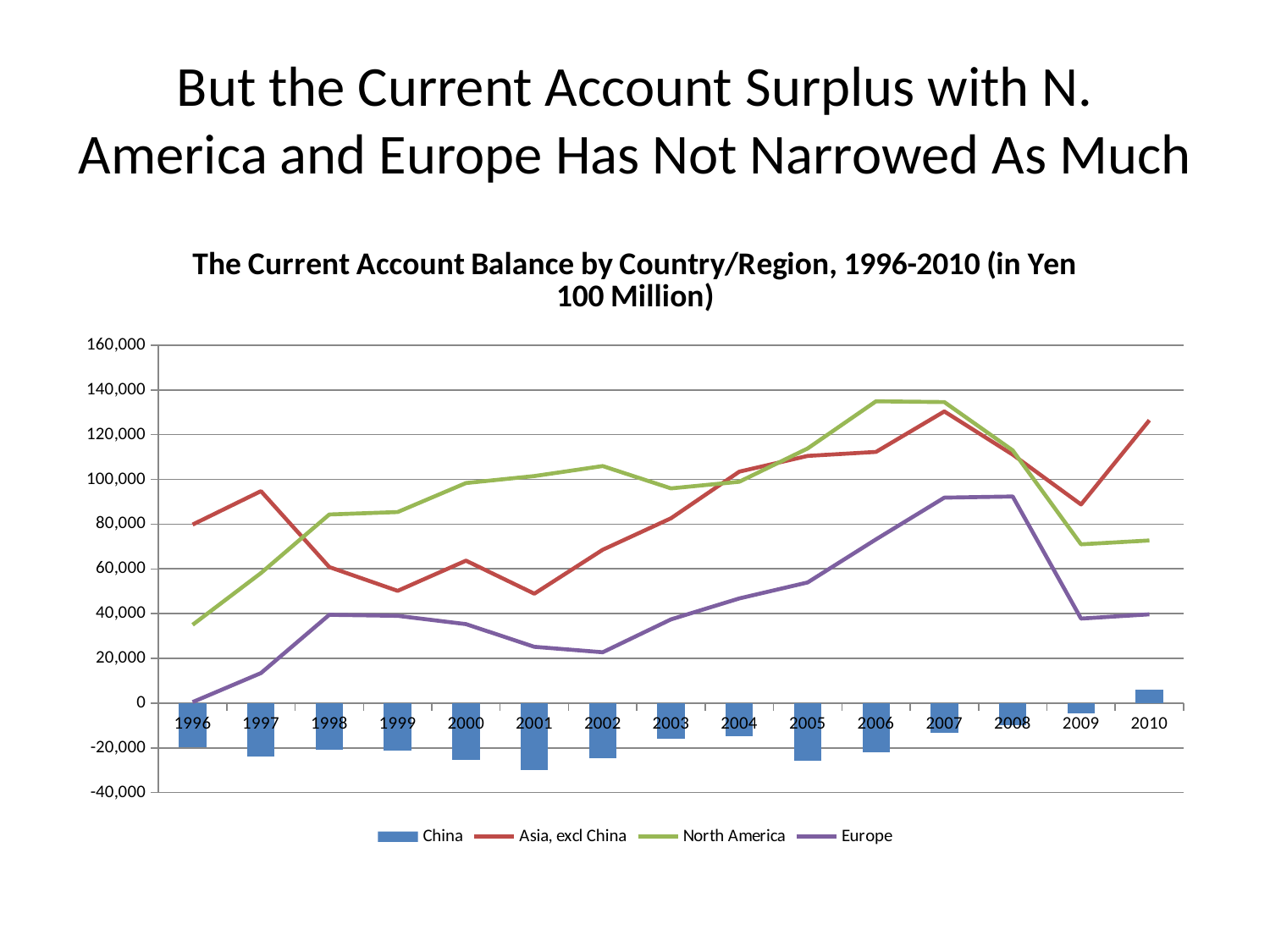
In 2010, which is larger: the value for Asia, excl China or the value for North America? Asia, excl China In which year is the value for North America the lowest? 1996 In which year is the value for China the lowest? 2001 What kind of chart is shown on the slide? A combination bar and line chart How many years are shown along the x axis of the chart? 15 How many series does the chart legend list? 4 Is the value for Europe in 1996 greater or less than 20,000? less Is the value for China in 2001 greater or less than -20,000? less In 2002, which is larger: the value for North America or the value for Europe? North America Is the value for Asia, excl China in 2007 greater or less than 120,000? greater Does the value for Europe rise or fall from 2002 to 2008? rise